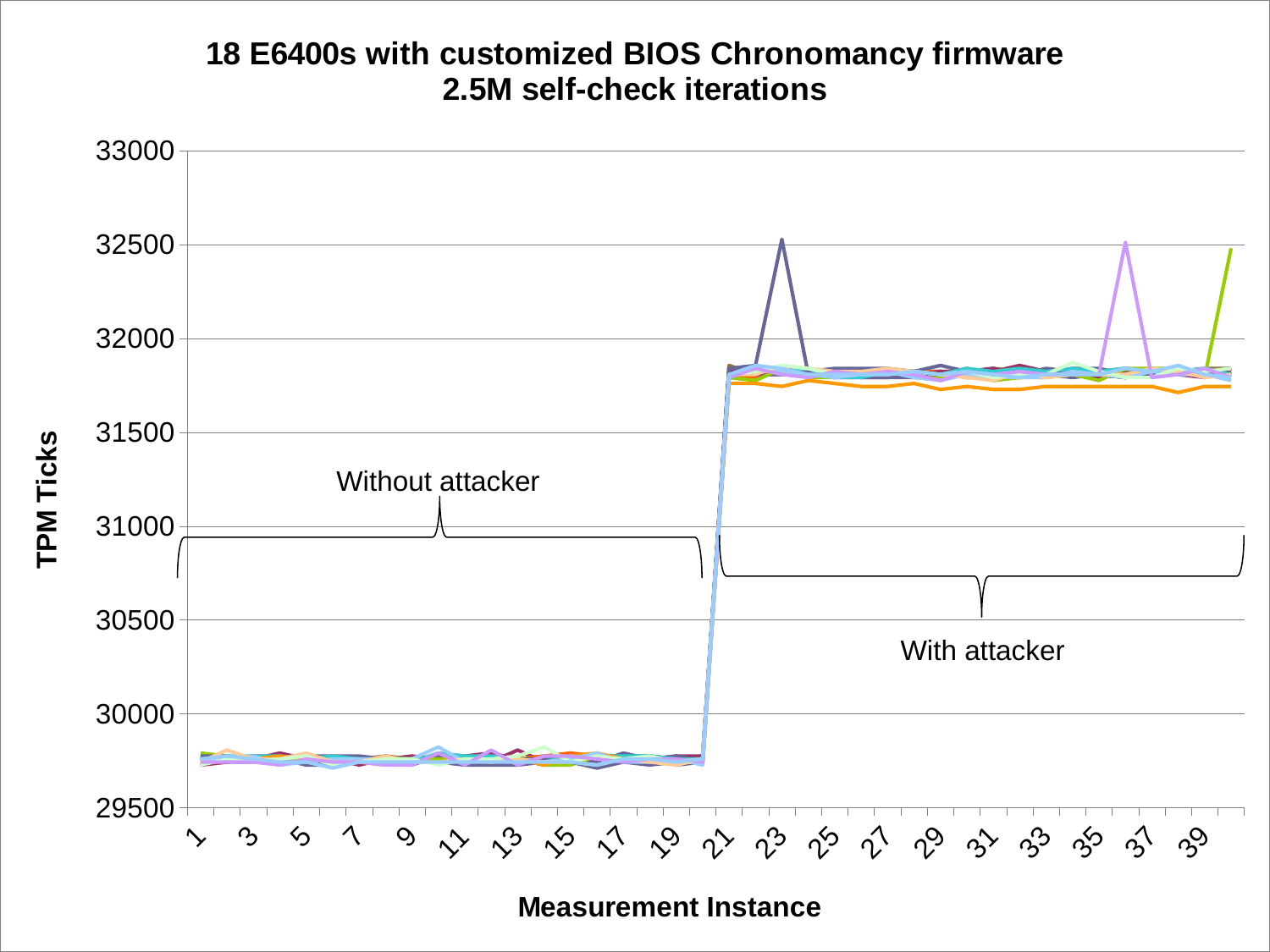
Which has larger values, measurement instance 5 or measurement instance 25? measurement instance 25 How many measurement instance labels are printed along the x axis? 20 Do the values rise or fall between measurement instance 20 and measurement instance 21? rise What kind of chart is shown on the slide? line chart Are the values at measurement instance 30 greater or less than 31500? greater What is the title of the chart? 18 E6400s with customized BIOS Chronomancy firmware 2.5M self-check iterations Are the values at measurement instance 15 greater or less than 30500? less Is the peak value at measurement instance 23 greater or less than 32000? greater What label is written under the brace covering measurement instances 21 to 40? With attacker Overall, do the values rise or fall from the left of the x axis to the right? rise